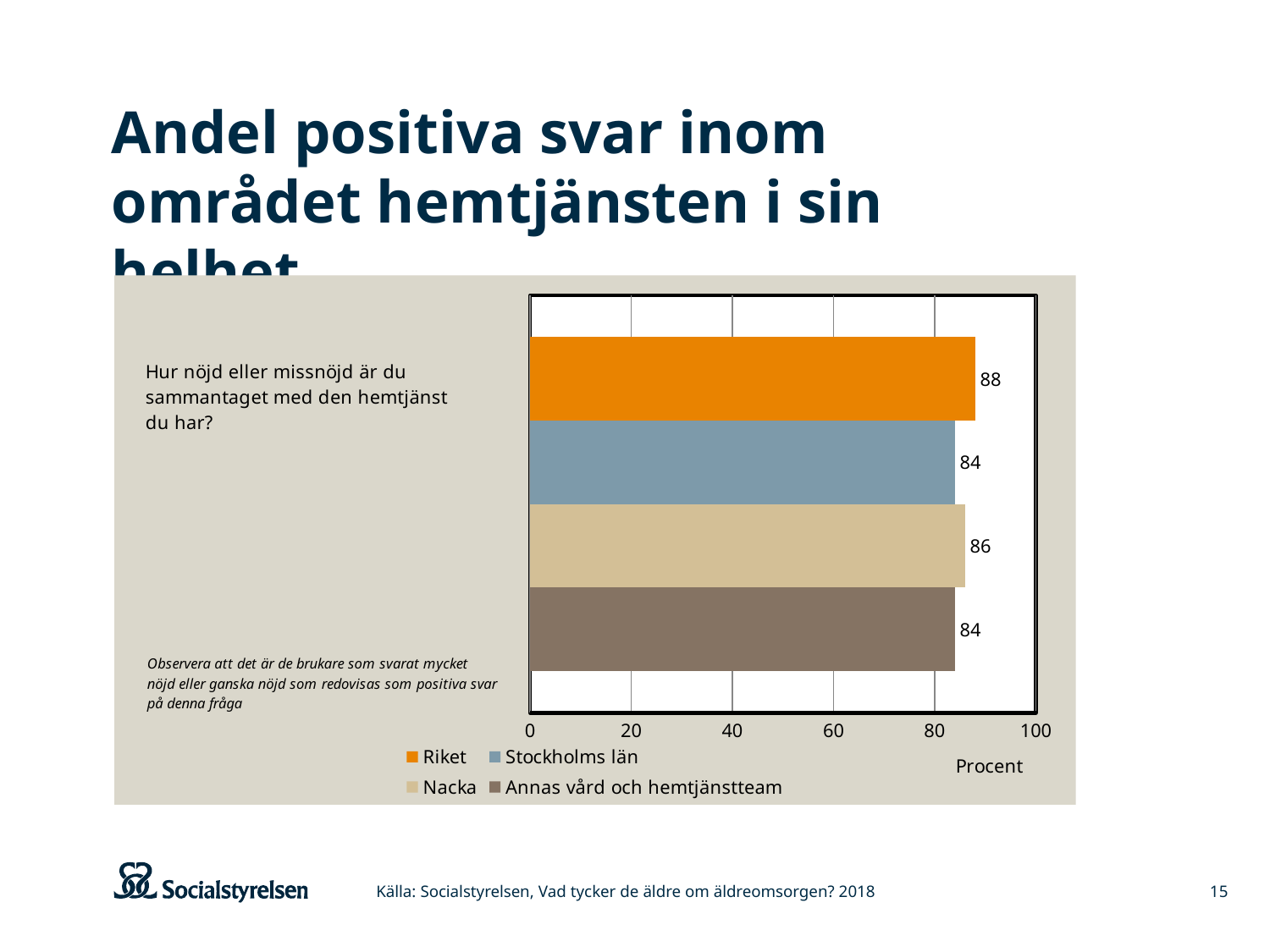
What kind of chart is shown on the slide? Bar chart What is the value for Riket? 88 What is the value for Nacka? 86 How many series does the legend list? 4 Which series has the highest value? Riket What is the difference between the values for Riket and Stockholms län? 4 What is the label of the horizontal axis? Procent What is the difference between the values for Riket and Nacka? 2 What is the value for Stockholms län? 84 Which is larger, the value for Nacka or the value for Annas vård och hemtjänstteam? Nacka What is the value for Annas vård och hemtjänstteam? 84 Is the value for Riket greater or less than 80? greater